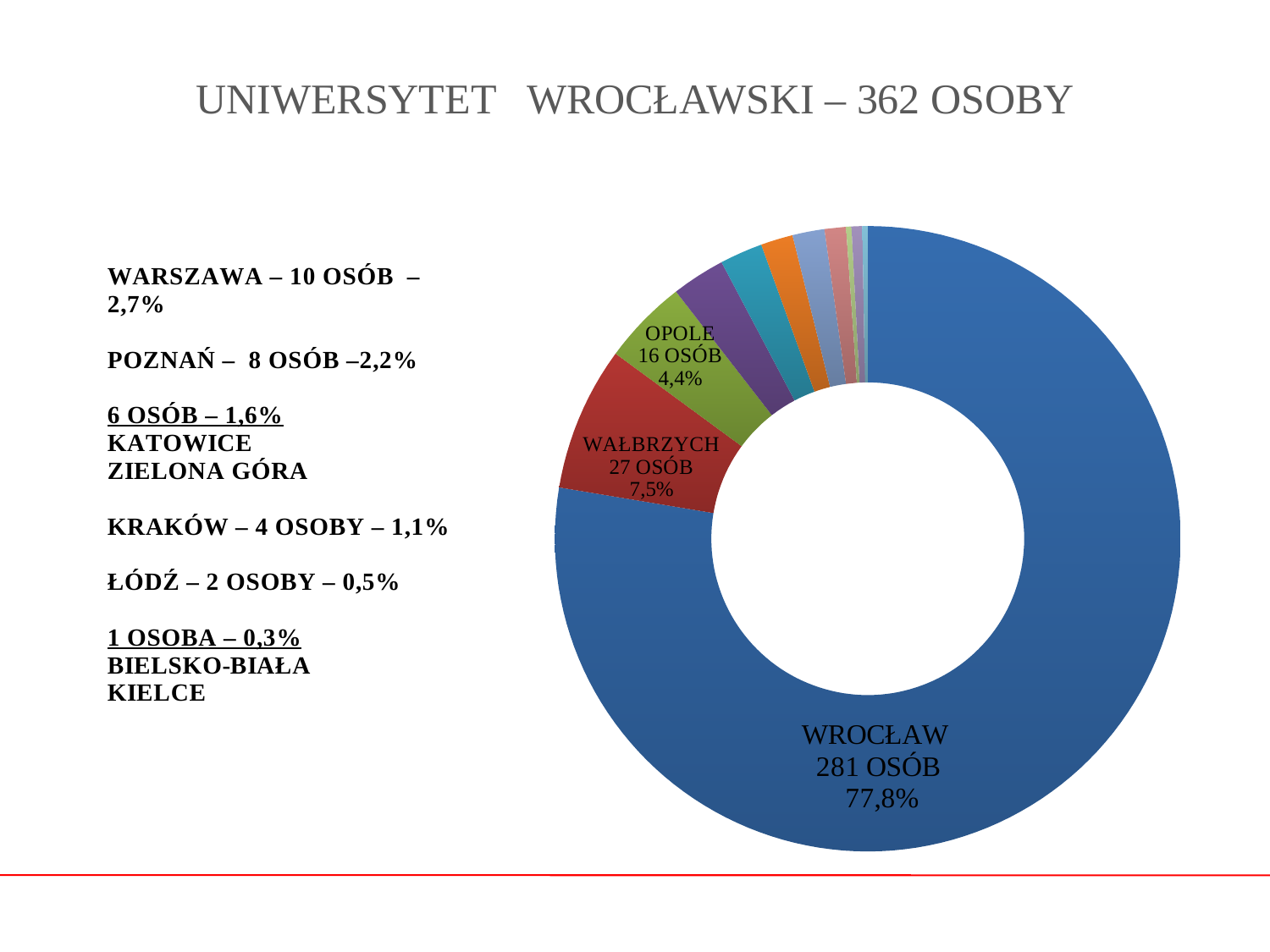
Which city has the largest slice of the chart? Wrocław Which is larger, the Wałbrzych slice or the Opole slice? Wałbrzych What percentage share is shown for Opole? 4,4% How many people does the Wrocław slice represent? 281 osób What is the difference in number of people between Wrocław and Wałbrzych? 254 What kind of chart is shown on the slide? Doughnut (pie) chart What is the difference in number of people between Wałbrzych and Opole? 11 What is the title of the slide containing the chart? UNIWERSYTET WROCŁAWSKI – 362 OSOBY What share of the chart does the Wrocław slice take? 77,8% What colour is the Wrocław slice? Blue How many people does the Opole slice represent? 16 osób What percentage share is shown for Wałbrzych? 7,5%